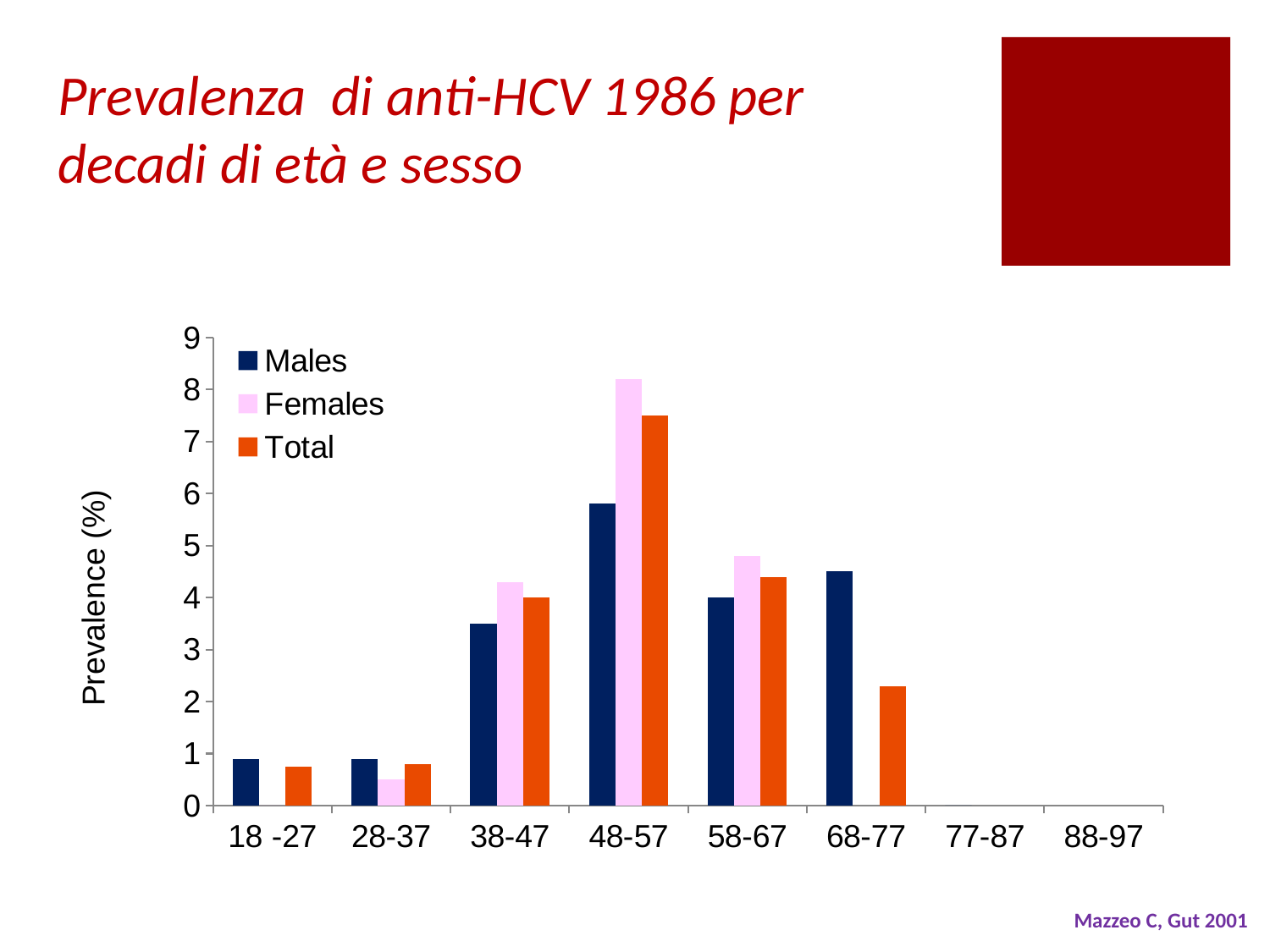
Is the Males value for 68-77 greater or less than 4? greater What kind of chart is shown on the slide? bar chart Is the Females value for 48-57 greater or less than 7? greater How many series does the legend list? 3 How many age-group categories are shown on the x axis? 8 What is the label of the y axis? Prevalence (%) Is the Total value for 68-77 greater or less than 3? less In the 48-57 age group, which is larger, the Males value or the Females value? Females In the 68-77 age group, which is larger, the Males value or the Total value? Males Which age group has the highest Females bar? 48-57 Which age group has the highest Total bar? 48-57